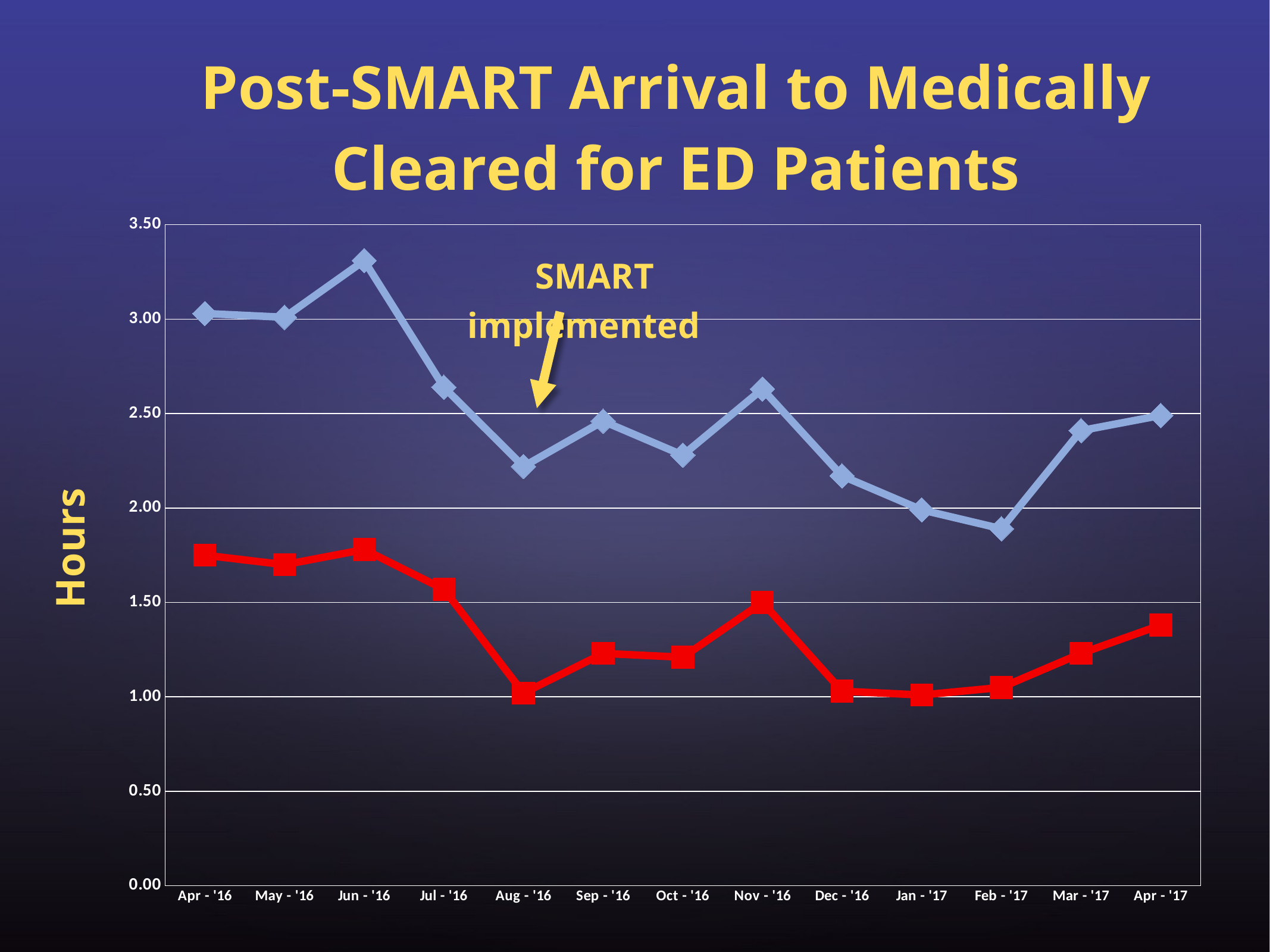
In which month does the blue line reach its highest value? Jun - '16 Is the value of the red line for Aug - '16 greater or less than 1.50? less How many lines (data series) are plotted on the chart? 2 Is the value of the red line for Jun - '16 greater or less than 1.50? greater Which is higher in Apr - '17, the blue line or the red line? the blue line In which month does the blue line reach its lowest value? Feb - '17 Is the value of the blue line for Jun - '16 greater or less than 3.00? greater How many months are plotted along the x axis? 13 What kind of chart is shown on the slide? line chart Does the blue line rise or fall from Jun - '16 to Aug - '16? fall What is the label on the vertical axis of the chart? Hours